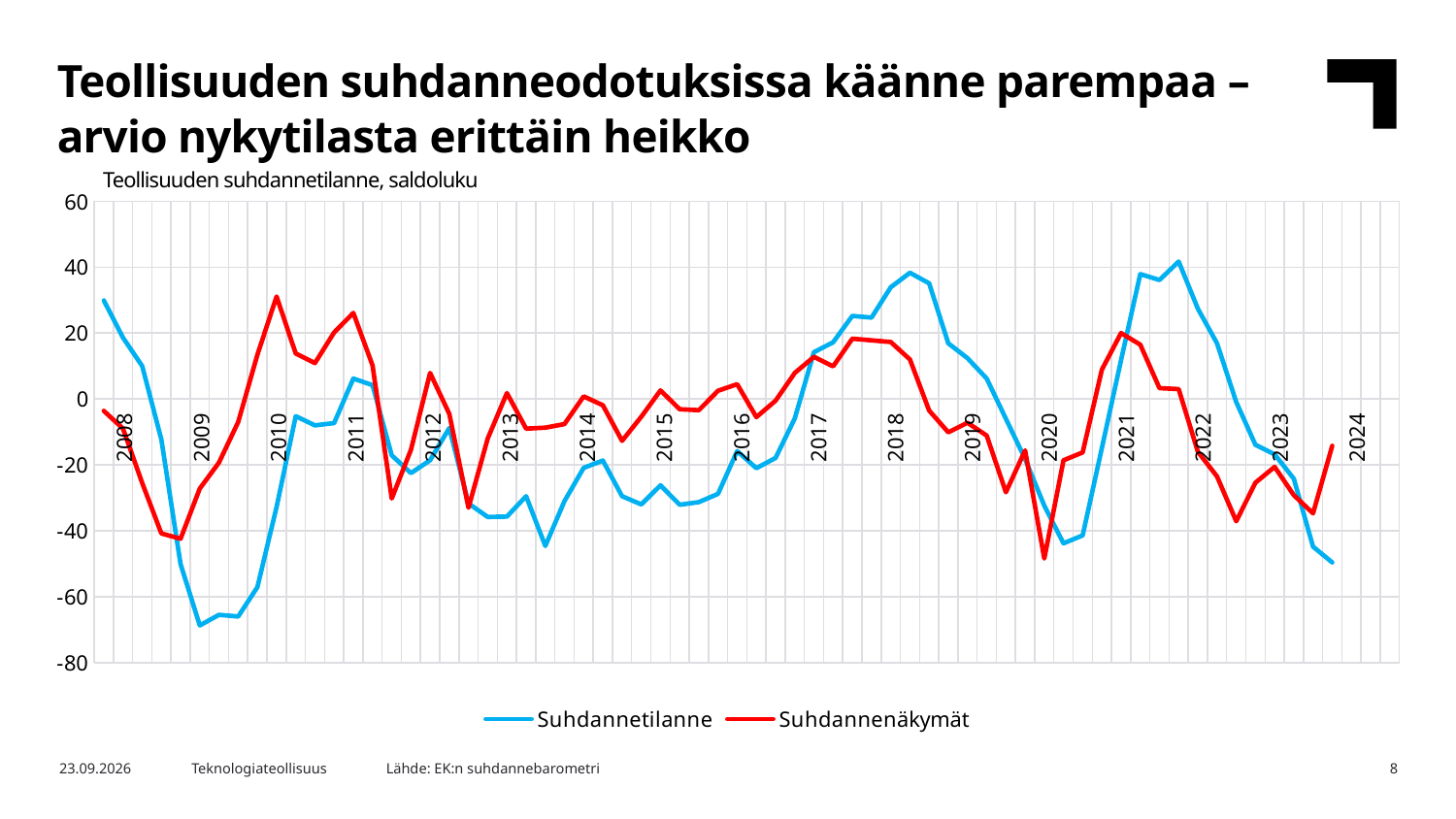
Is the lowest value of the Suhdannetilanne series (around 2009) greater or less than -60? less Does the Suhdannetilanne series rise or fall from 2021 to 2024? fall How many series does the legend list? 2 Is the lowest value of the Suhdannenäkymät series (around 2020) greater or less than -40? less Is the last plotted value of the Suhdannetilanne series (2024) greater or less than -40? less What kind of chart is shown on the slide? line chart Which colour is used for the Suhdannenäkymät series? red Around 2009, which series has the lower value, Suhdannetilanne or Suhdannenäkymät? Suhdannetilanne At the end of the series in 2024, which series has the higher value, Suhdannetilanne or Suhdannenäkymät? Suhdannenäkymät What is the chart's subtitle above the plot area? Teollisuuden suhdannetilanne, saldoluku How many year labels are shown on the x axis? 17